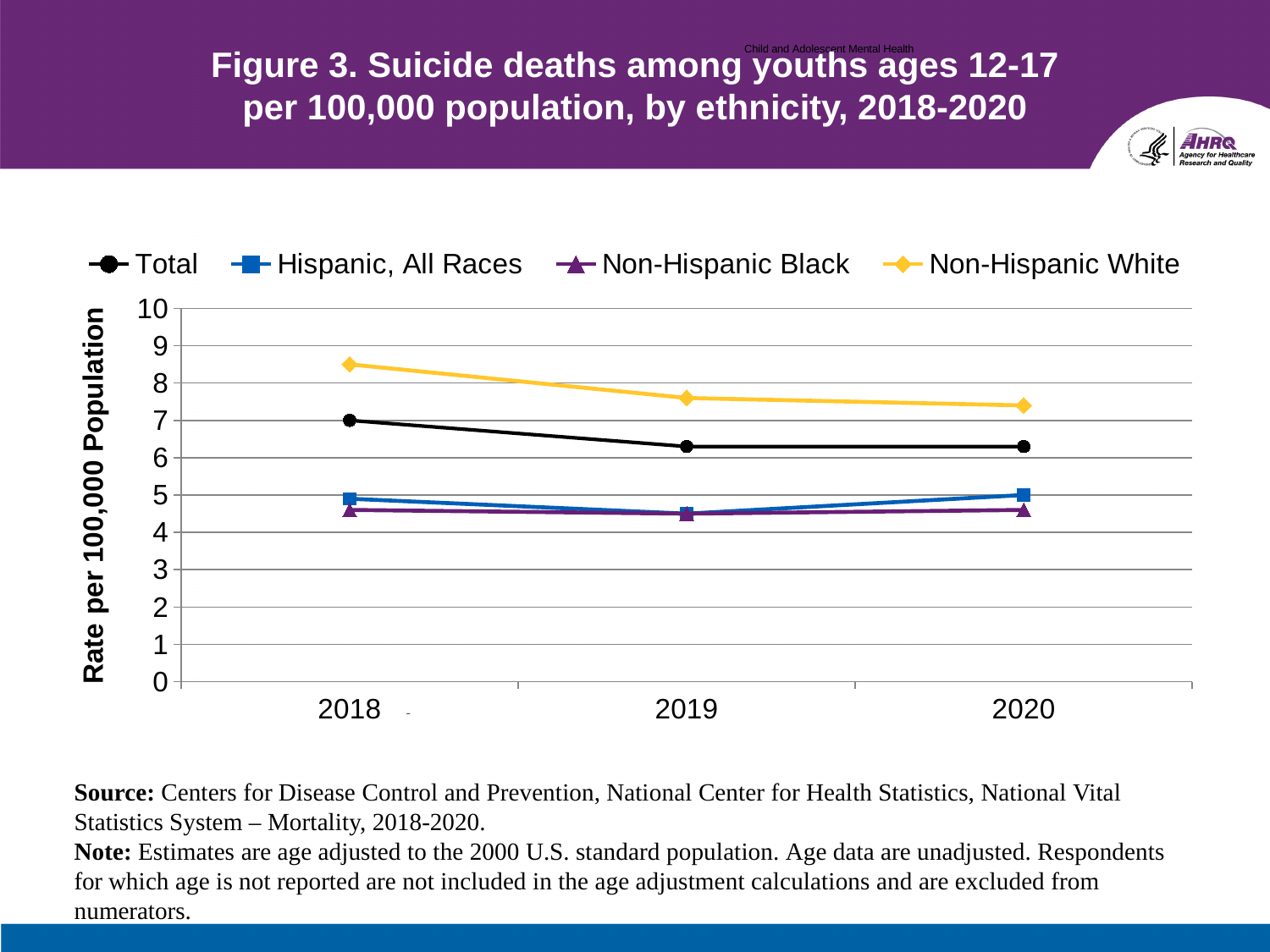
What is the title of the y axis? Rate per 100,000 Population Which group had the highest suicide death rate in 2018? Non-Hispanic White Which is larger in 2020, the rate for Total or the rate for Hispanic, All Races? Total What kind of chart is shown on the slide? line chart Does the rate for Non-Hispanic White rise or fall from 2018 to 2020? fall Is the value for Total in 2019 greater or less than 7? less Is the value for Non-Hispanic Black in 2018 greater or less than 5? less Is the value for Non-Hispanic White in 2018 greater or less than 8? greater How many series does the legend list? 4 How many years are plotted along the x axis? 3 Which group had the lowest suicide death rate in 2020? Non-Hispanic Black